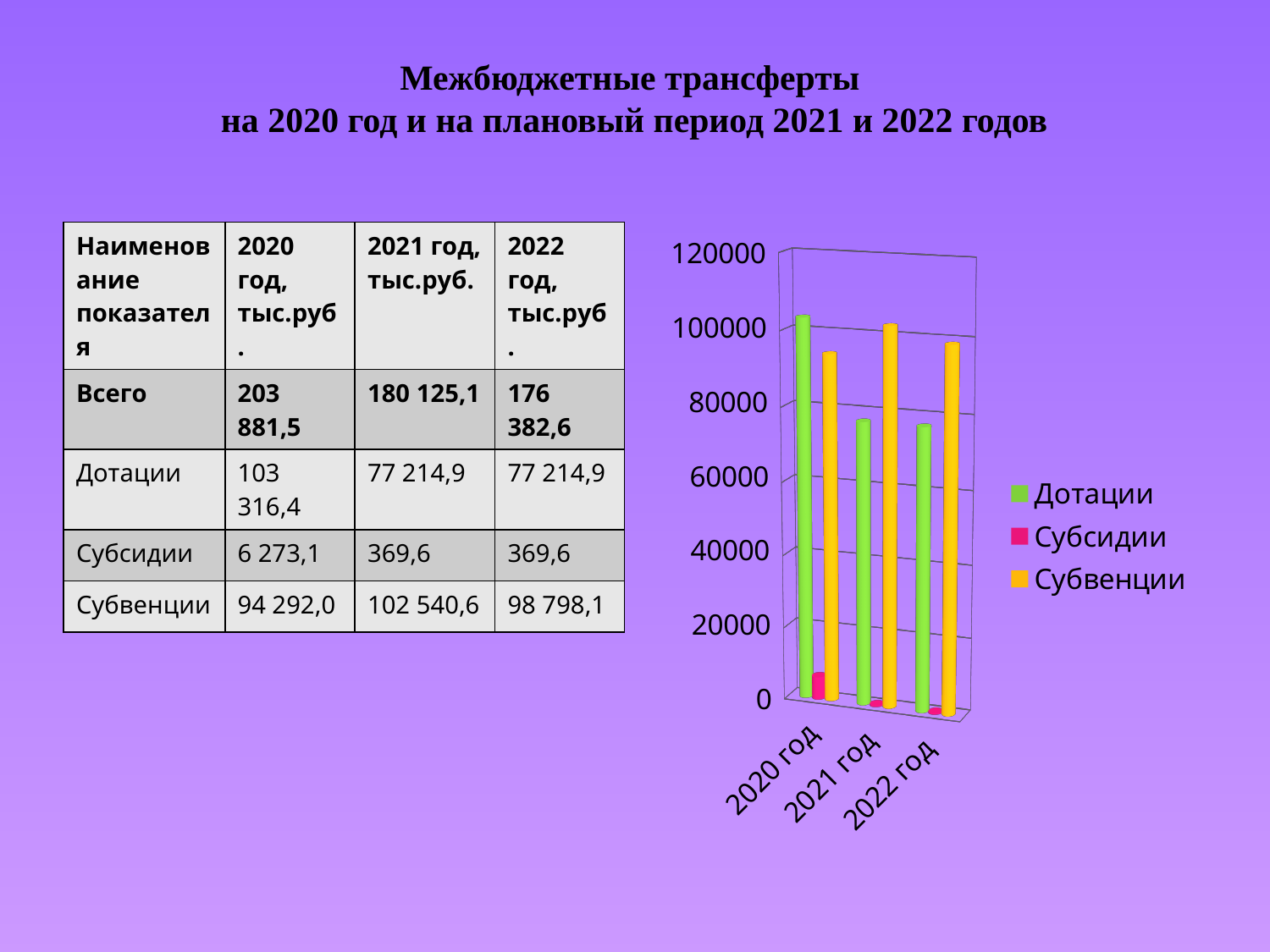
How many series does the chart legend list? 3 For 2021 год, which is larger: Дотации or Субвенции? Субвенции Is the Субвенции bar for 2020 год greater or less than 100000? less Is the Субсидии bar for 2020 год greater or less than 20000? less What kind of chart is shown on the slide? bar chart Which series has the shortest bar for 2020 год? Субсидии How many year categories are shown on the x axis of the chart? 3 Is the Дотации bar for 2020 год greater or less than 100000? greater Do the Дотации bars rise or fall from 2020 год to 2021 год? fall Which series is shown in yellow in the chart legend? Субвенции Which series has the tallest bar for 2020 год? Дотации